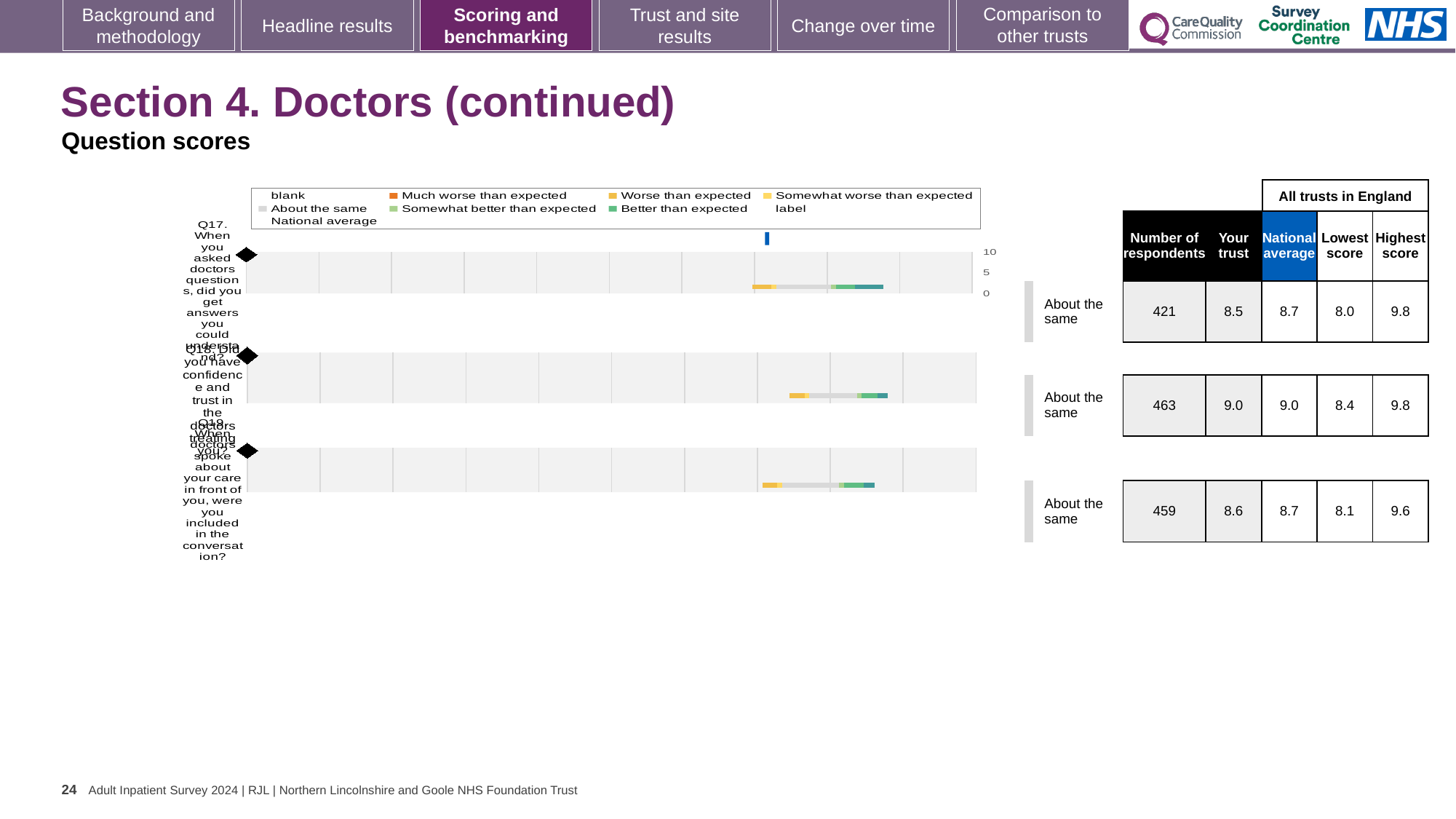
Which question has the highest 'Your trust' score? Q18 For Q17, which is larger: the 'Your trust' score or the national average? National average What benchmark category is shown for all three questions in the chart? About the same What is the maximum value shown on the chart's score axis? 10 Which question has the fewest respondents? Q17 How many questions (categories) are plotted in the chart? 3 How many respondents answered Q18 (Did you have confidence and trust in the doctors treating you)? 463 What is the highest score among all trusts in England for Q19? 9.6 What is the lowest score among all trusts in England for Q18? 8.4 What kind of chart is shown on the slide? bar chart What is the 'Your trust' score for Q17 (When you asked doctors questions, did you get answers you could understand)? 8.5 What is the difference between the 'Your trust' scores for Q18 and Q17? 0.5